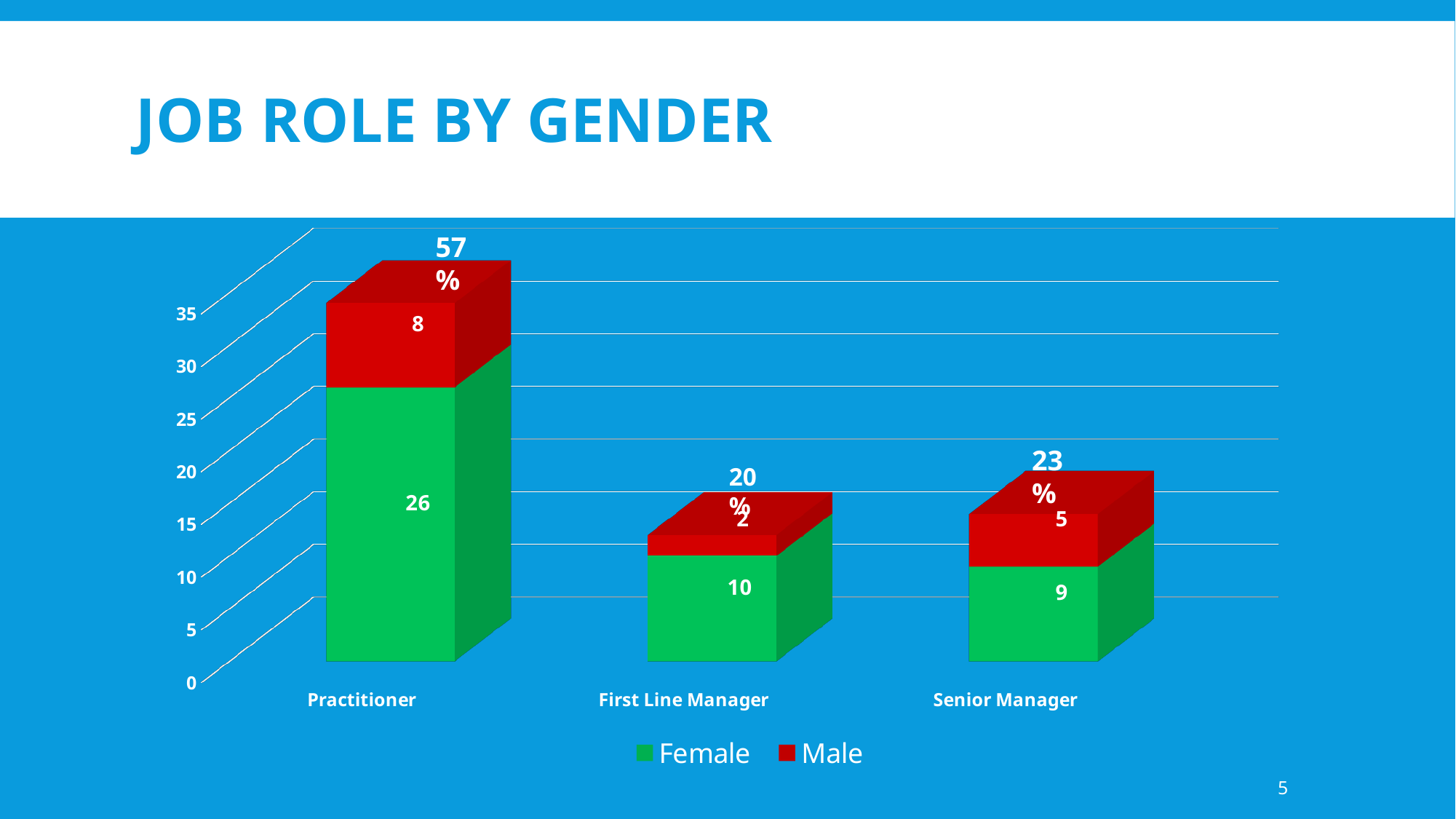
What is the difference between the Female values for Practitioner and First Line Manager? 16 What is the Female value for Practitioner? 26 Which job role has the highest Female value? Practitioner Which is larger, the Male value for Practitioner or the Male value for Senior Manager? Practitioner What kind of chart is shown on the slide? Stacked bar chart What is the Male value for Senior Manager? 5 What is the Male value for First Line Manager? 2 How many job role categories are shown on the x axis? 3 What percentage label is shown above the Practitioner bar? 57% What is the total of the stacked bar for Senior Manager (Female plus Male)? 14 How many series does the legend list? 2 Which job role has the lowest Male value? First Line Manager